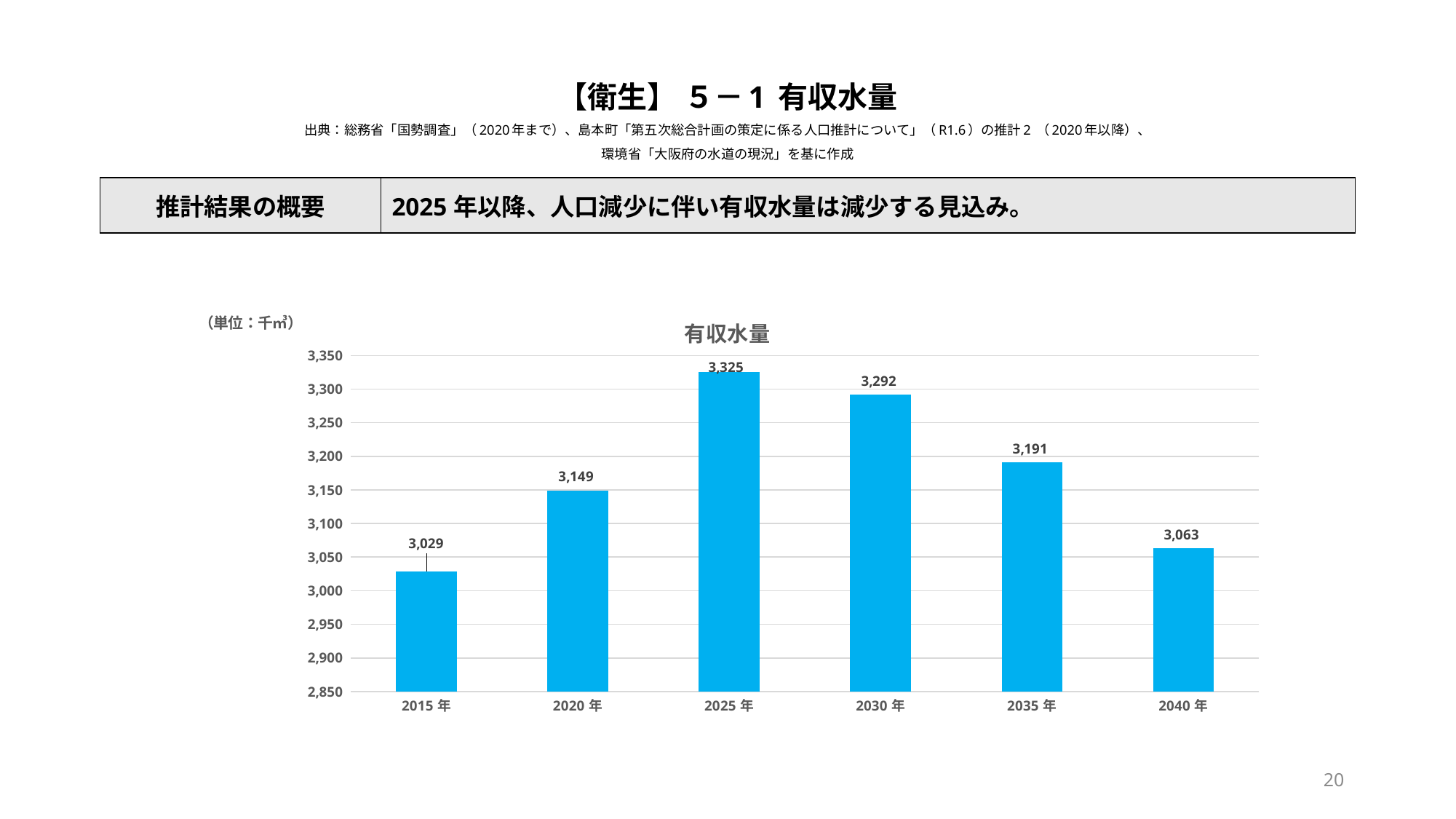
What is the value for 2030年 in the 有収水量 chart? 3,292 What is the value for 2015年 in the 有収水量 chart? 3,029 Which is larger, the value for 2035年 or the value for 2040年? 2035年 Is the value for 2020年 greater or less than 3,100? greater Which year has the highest value in the 有収水量 chart? 2025年 What is the difference between the values for 2025年 and 2040年? 262 What is the title of the chart? 有収水量 How many years are shown on the x axis of the chart? 6 What is the value for 2040年 in the 有収水量 chart? 3,063 What is the difference between the values for 2020年 and 2015年? 120 What kind of chart is shown on the slide? bar chart Which year has the lowest value in the 有収水量 chart? 2015年